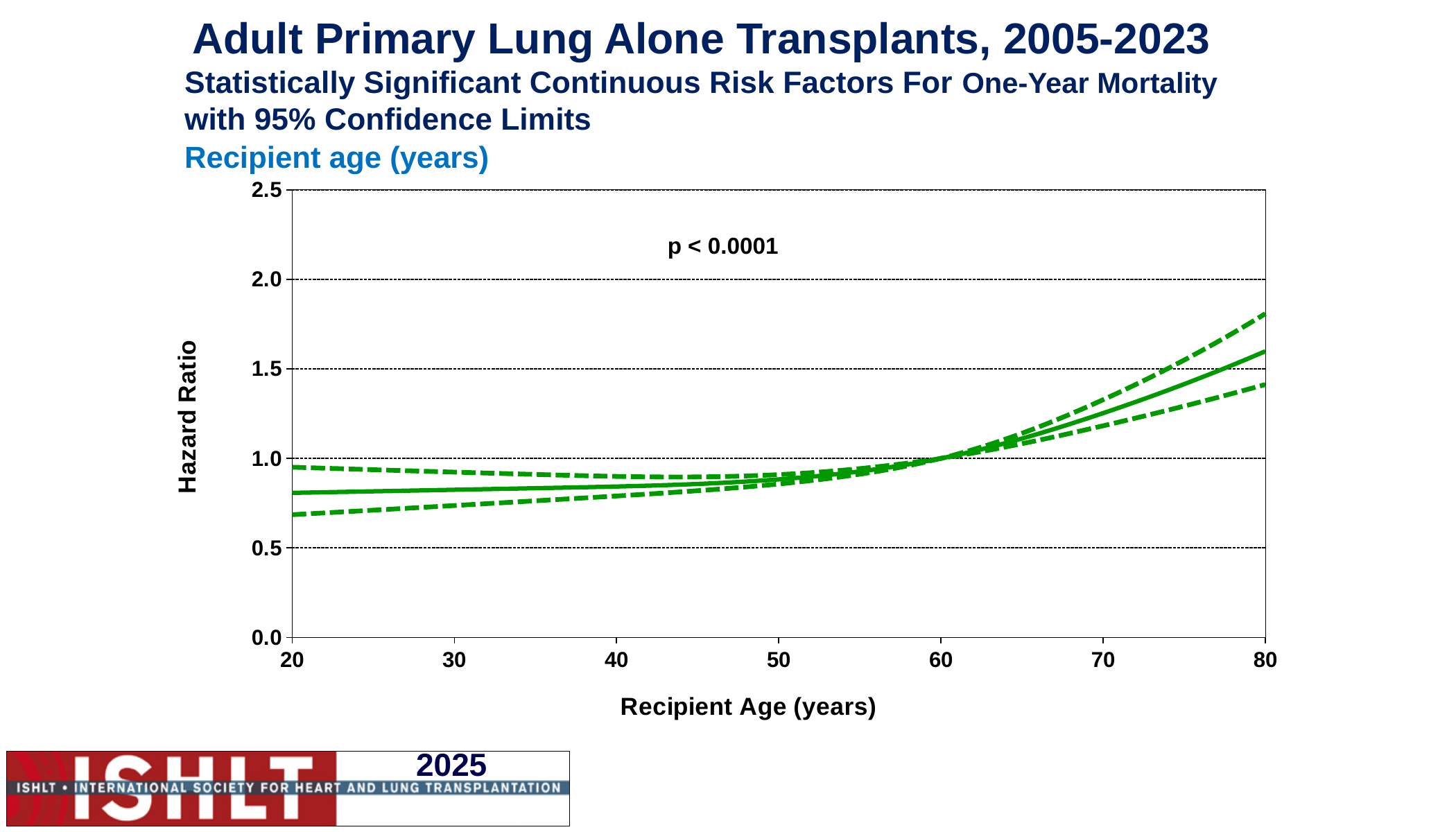
What is the title of the chart on the slide? Adult Primary Lung Alone Transplants, 2005-2023 Is the upper 95% confidence limit (upper dashed line) at recipient age 80 greater or less than 1.5? greater Is the lower 95% confidence limit (lower dashed line) at recipient age 20 greater or less than 0.5? greater What is the label of the y axis? Hazard Ratio Is the hazard ratio (solid line) at recipient age 20 greater or less than 1.0? less What kind of chart is shown on the slide? Line chart Which recipient age has the larger hazard ratio on the solid line, 20 years or 80 years? 80 years What p-value is printed on the chart? p < 0.0001 Does the hazard ratio (solid line) rise or fall as recipient age increases from 20 to 80 years? Rise